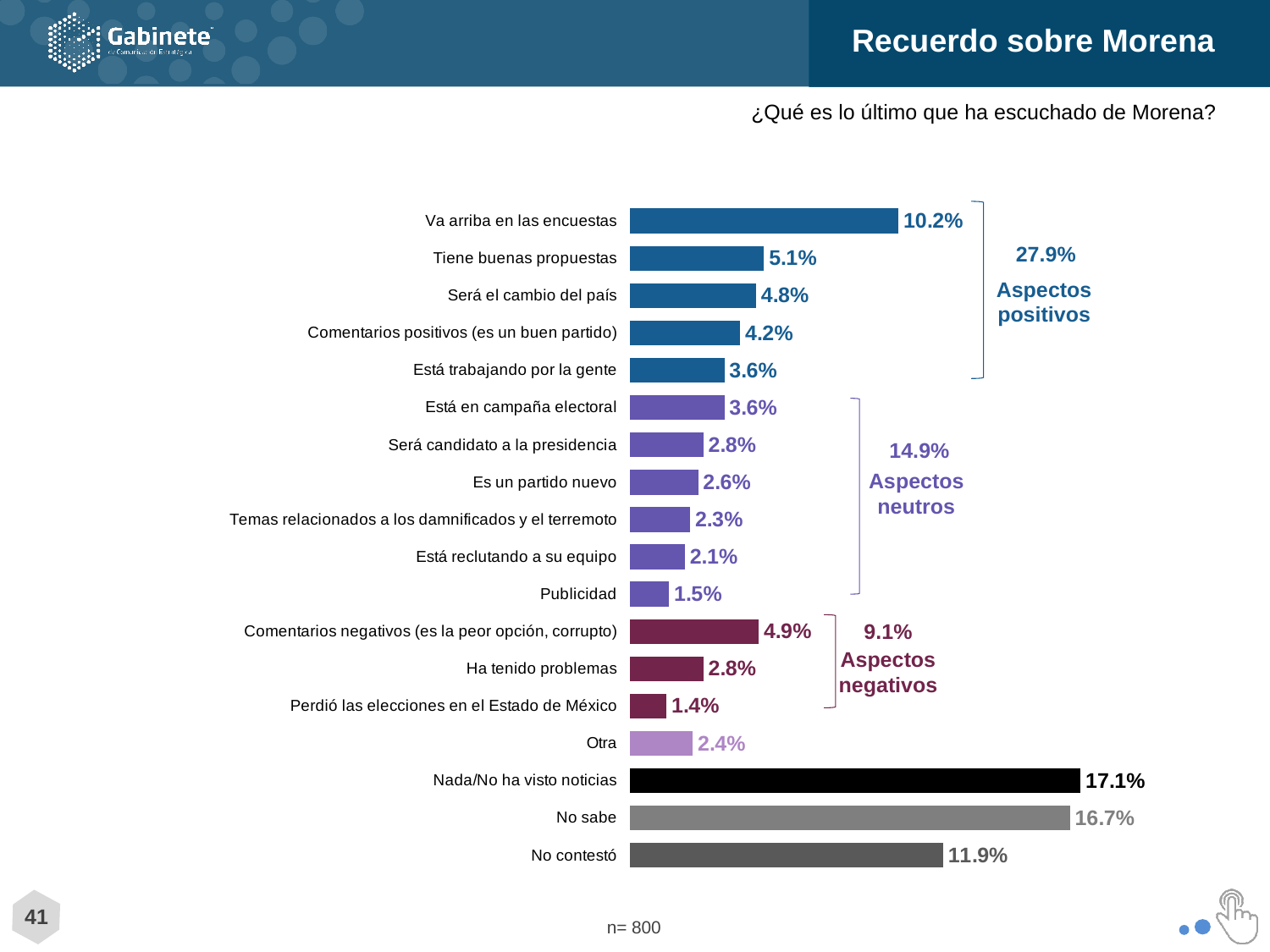
What is the value for "No contestó"? 11.9% What is the combined total shown for "Aspectos negativos"? 9.1% What is the combined total shown for "Aspectos positivos"? 27.9% What is the value for "Publicidad"? 1.5% How many categories are shown in the chart? 18 What kind of chart is shown on the slide? Bar chart What is the difference between "Nada/No ha visto noticias" and "No sabe"? 0.4% What is the value for "Va arriba en las encuestas"? 10.2% Which is larger, "Tiene buenas propuestas" or "Comentarios negativos (es la peor opción, corrupto)"? Tiene buenas propuestas Which category has the lowest value? Perdió las elecciones en el Estado de México What is the value for "Nada/No ha visto noticias"? 17.1% Which category has the highest value? Nada/No ha visto noticias